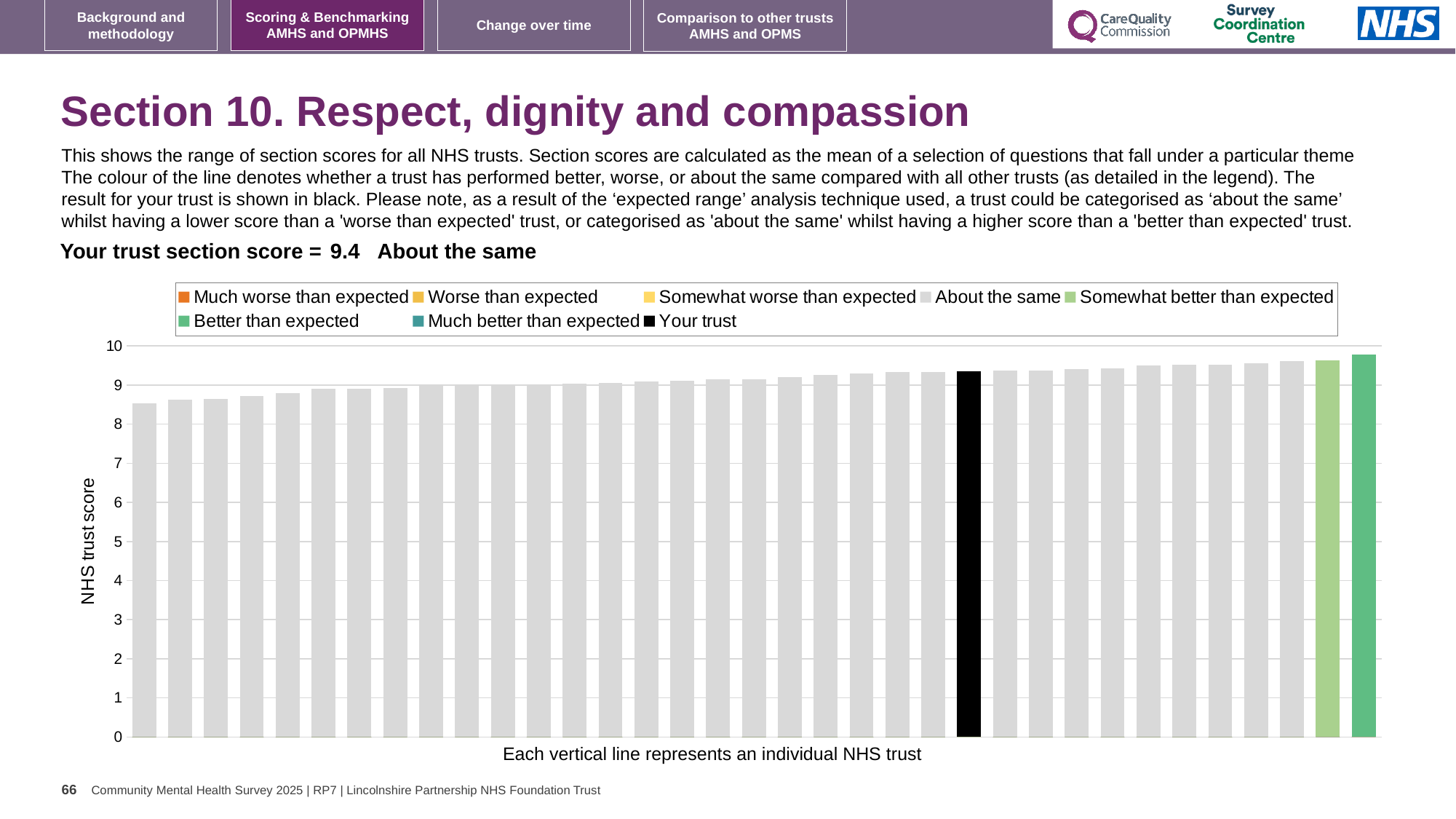
Is the value for your trust (the black bar) greater or less than 9? greater Which legend category does the highest bar on the chart belong to? Better than expected Is the value of the rightmost bar greater or less than 10? less Is the bar for your trust higher or lower than the leftmost bar? higher What is the section score for your trust shown on the slide? 9.4 How many entries does the chart legend list? 8 What is the label on the vertical axis of the chart? NHS trust score Do the bar values rise or fall from left to right along the x axis? rise Is the value of the leftmost bar greater or less than 8? greater How many bars (individual NHS trusts) are plotted on the chart? 35 What kind of chart is shown on the slide? Bar chart Which benchmarking category is your trust placed in for this section? About the same